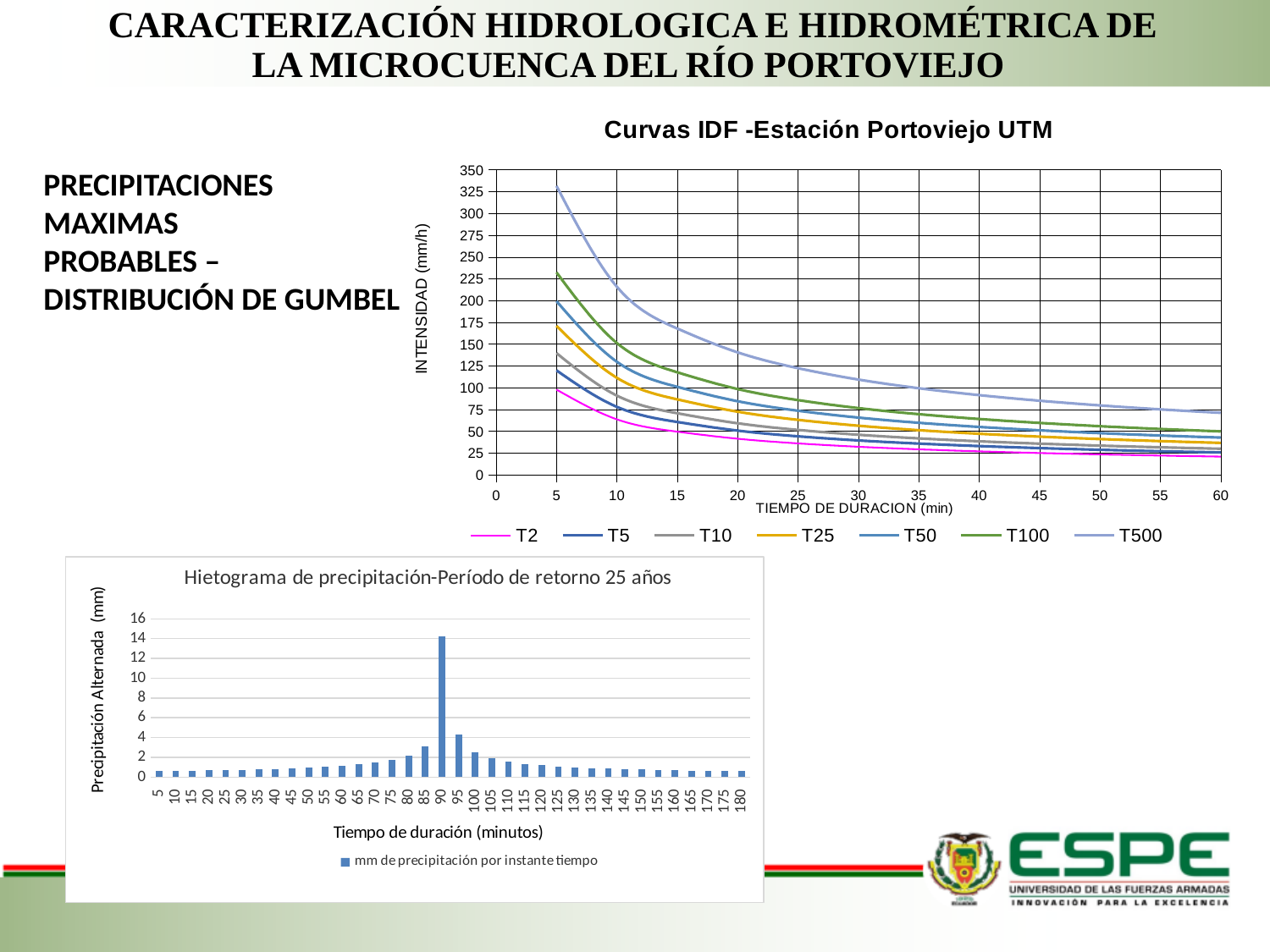
What type of chart is the 'Hietograma de precipitación-Período de retorno 25 años' chart? bar chart In the 'Curvas IDF - Estación Portoviejo UTM' chart, which series has the larger intensity at 30 minutes, T100 or T5? T100 In the 'Curvas IDF - Estación Portoviejo UTM' chart, is the T500 intensity at 5 minutes greater or less than 300? greater In the 'Hietograma de precipitación-Período de retorno 25 años' chart, at which duration (minutes) is the precipitation highest? 90 What type of chart is the 'Curvas IDF - Estación Portoviejo UTM' chart? line chart In the 'Hietograma de precipitación-Período de retorno 25 años' chart, is the value at 90 minutes greater or less than 12? greater What is the label of the x axis of the 'Curvas IDF - Estación Portoviejo UTM' chart? TIEMPO DE DURACION (min) In the 'Curvas IDF - Estación Portoviejo UTM' chart, which series has the lowest intensity values? T2 How many series does the legend of the 'Curvas IDF - Estación Portoviejo UTM' chart list? 7 In the 'Curvas IDF - Estación Portoviejo UTM' chart, is the T500 intensity at 60 minutes greater or less than 100? less In the 'Curvas IDF - Estación Portoviejo UTM' chart, do the intensity values rise or fall as the duration increases? fall In the 'Curvas IDF - Estación Portoviejo UTM' chart, which series has the highest intensity values? T500